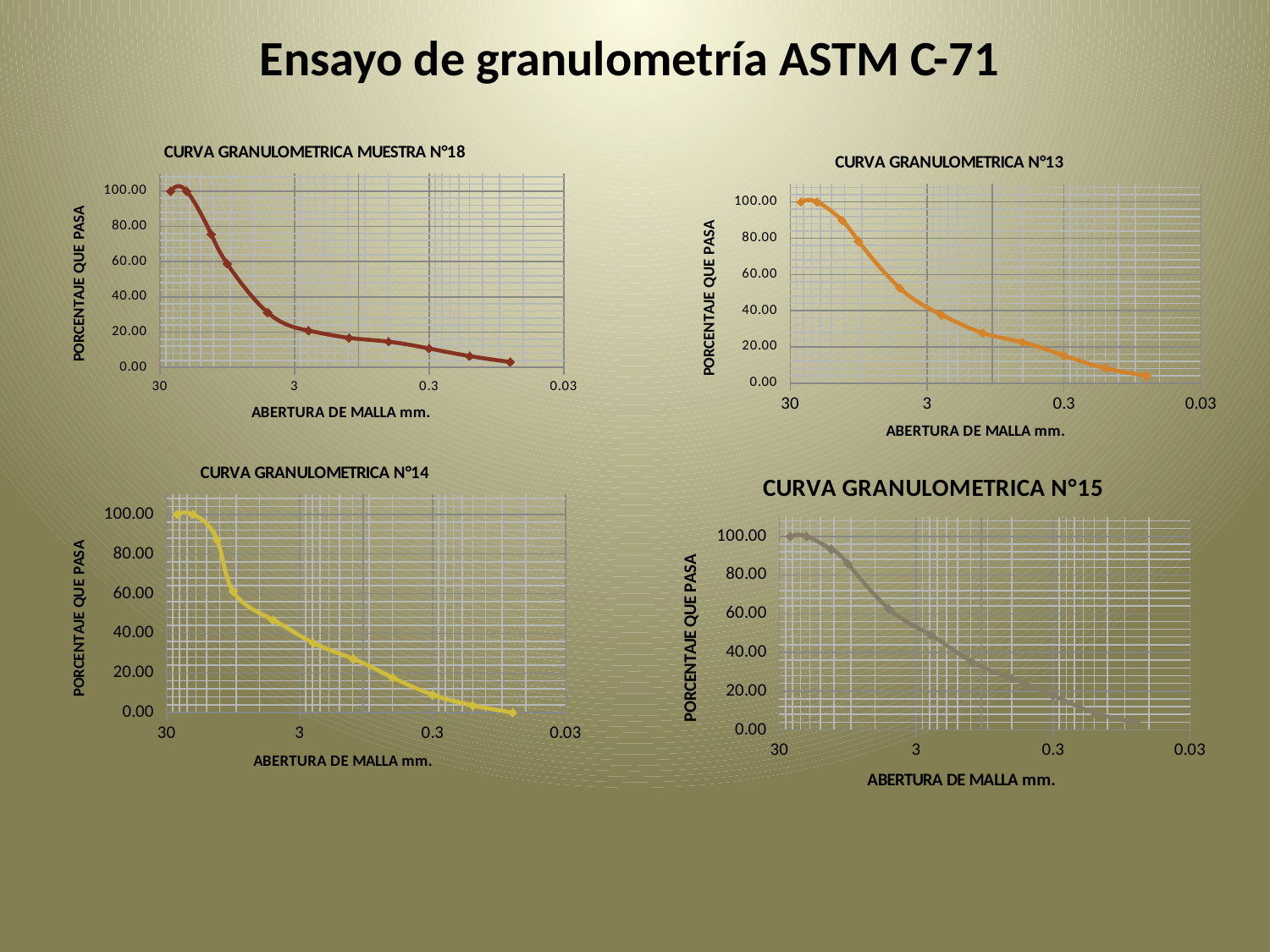
In CURVA GRANULOMETRICA N°13, is the value at an opening of 0.3 mm greater or less than 20.00? less In CURVA GRANULOMETRICA N°13, is the value at an opening of 3 mm greater or less than 20.00? greater In CURVA GRANULOMETRICA N°15, is the value at an opening of 3 mm greater or less than 20.00? greater In CURVA GRANULOMETRICA MUESTRA N°18, do the values rise or fall as the mesh opening decreases from 30 to 0.03 mm along the x axis? fall What is the x-axis title of CURVA GRANULOMETRICA N°15? ABERTURA DE MALLA mm. What is the y-axis title of CURVA GRANULOMETRICA N°14? PORCENTAJE QUE PASA In CURVA GRANULOMETRICA N°13, do the values rise or fall moving left to right along the x axis? fall How many charts are shown on the slide? 4 What kind of chart is CURVA GRANULOMETRICA MUESTRA N°18? line chart